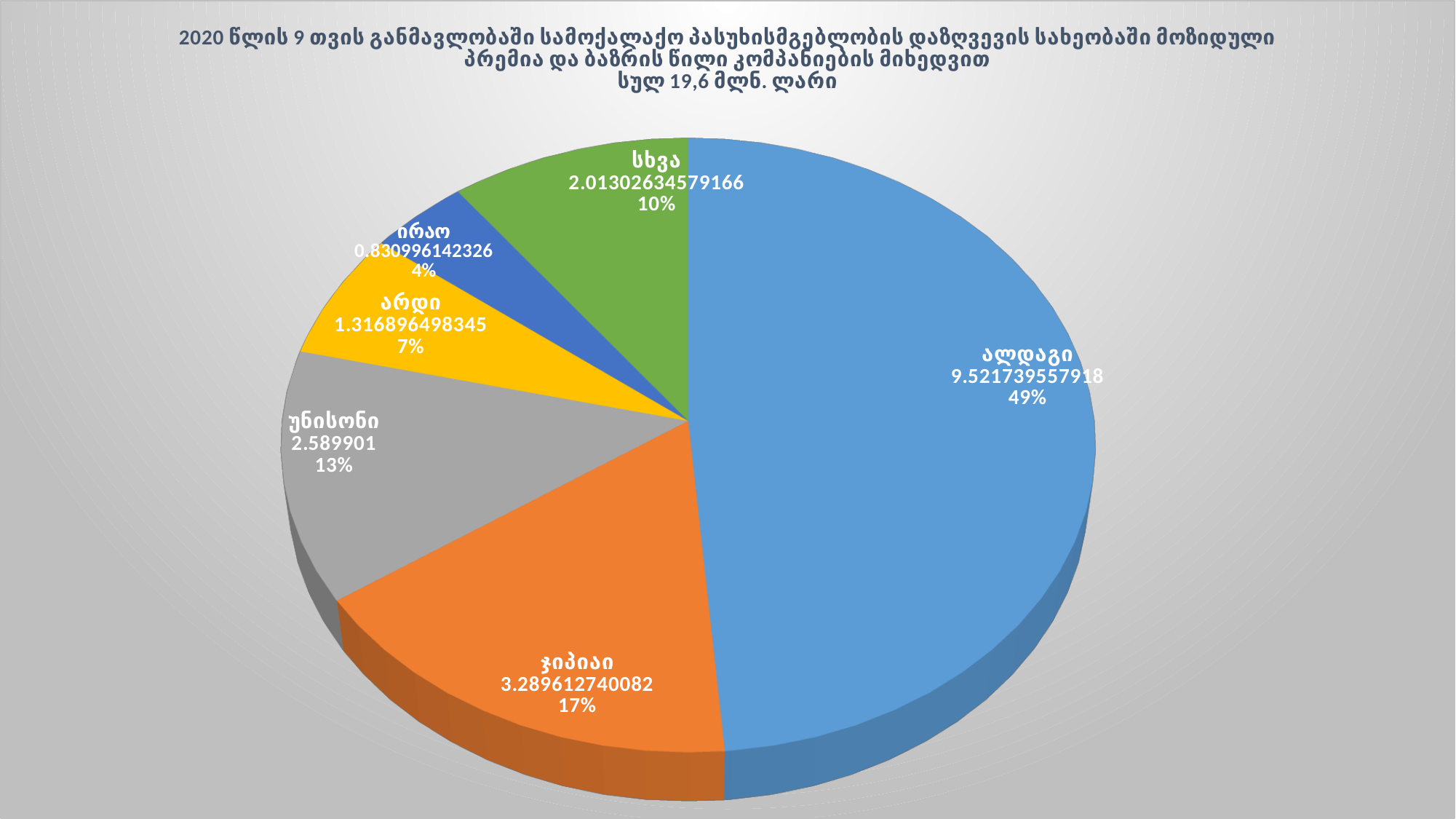
What value is shown for ალდაგი? 9.521739557918 What total amount is stated in the chart title? 19,6 მლნ. ლარი Which company has the smallest slice of the pie? ირაო What value is shown for უნისონი? 2.589901 Which company has the largest slice of the pie? ალდაგი What share of the pie does სხვა represent? 10% What value is shown for ჯიპიაი? 3.289612740082 What value is shown for ირაო? 0.830996142326 What share of the pie does არდი represent? 7% How many slices does the pie chart have? 6 What kind of chart is shown on the slide? pie chart Which is larger, the share for უნისონი or the share for სხვა? უნისონი